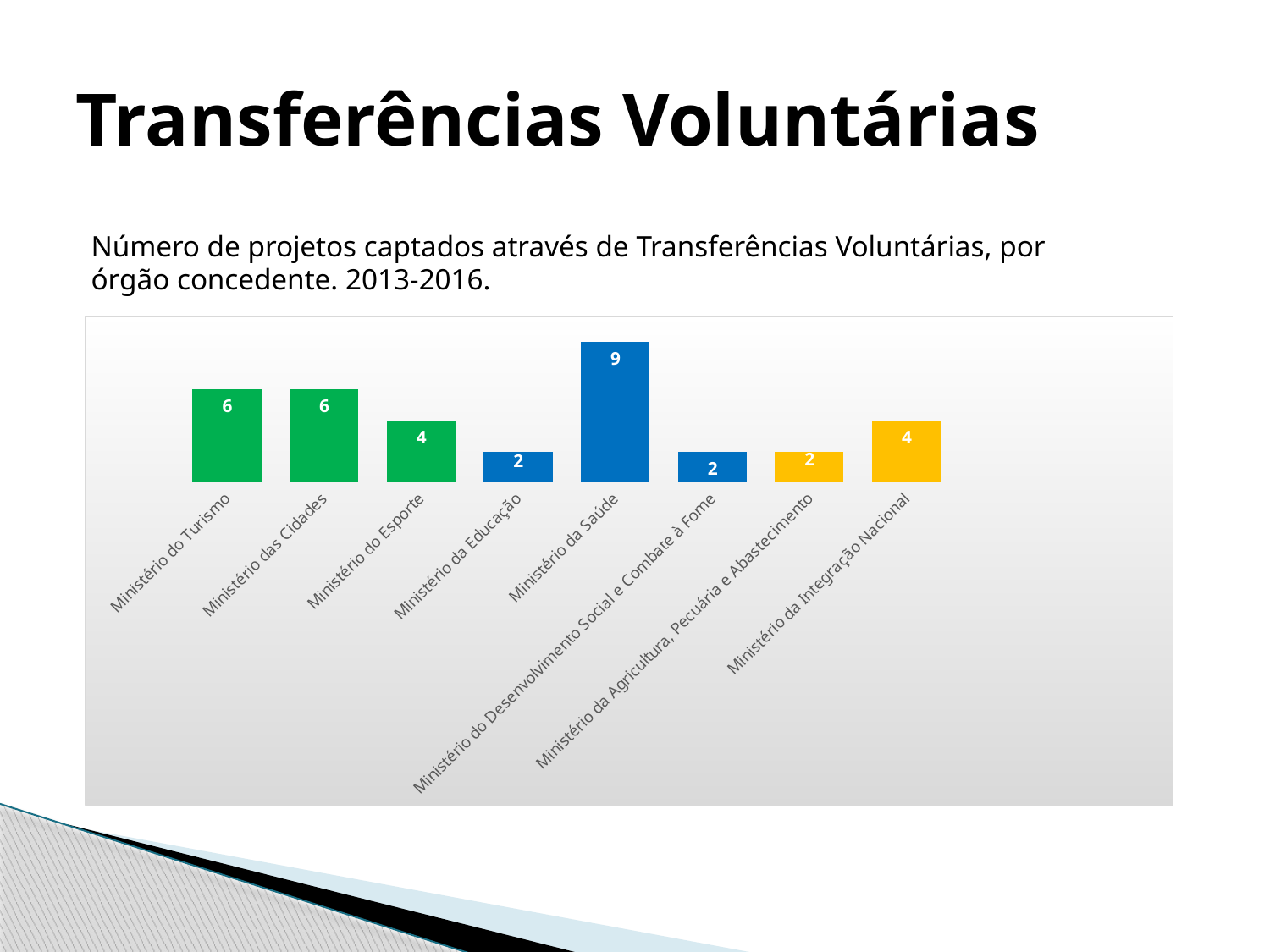
Which is larger, the value for Ministério do Esporte or the value for Ministério da Agricultura, Pecuária e Abastecimento? Ministério do Esporte What is the difference between the values for Ministério da Saúde and Ministério do Esporte? 5 What kind of chart is shown on the slide? bar chart How many granting bodies (categories) are shown in the chart? 8 What is the value for Ministério do Turismo? 6 What is the value for Ministério da Educação? 2 What is the total number of projects for Ministério do Turismo and Ministério das Cidades combined? 12 Which granting body has the highest number of projects? Ministério da Saúde How many projects were captured through the Ministério da Saúde? 9 What is the value for Ministério da Integração Nacional? 4 What colour is the bar for Ministério da Saúde? blue What is the difference between the values for Ministério das Cidades and Ministério da Educação? 4